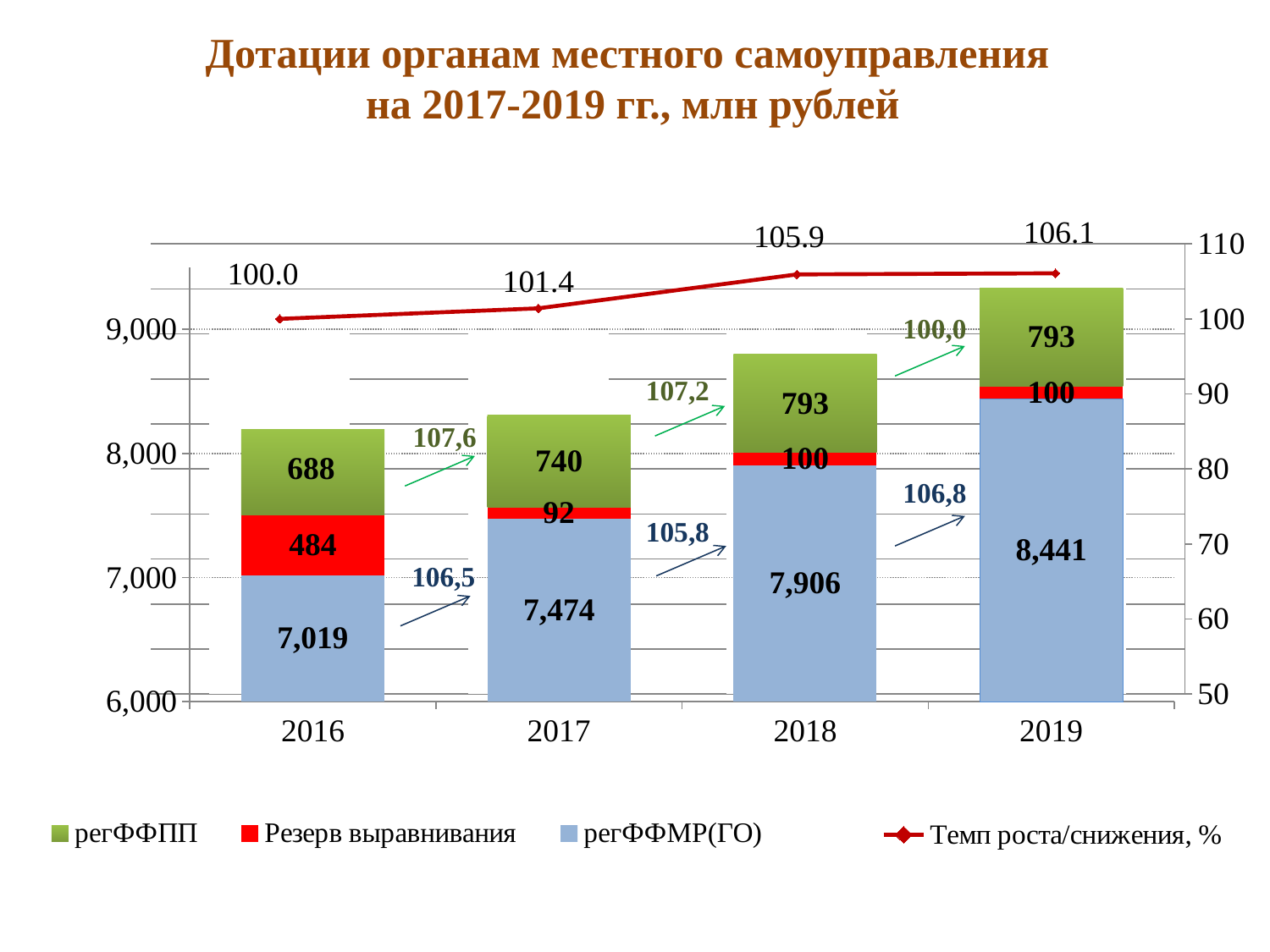
In which year is регФФМР(ГО) highest? 2019 What is the total of the stacked bar for 2016? 8,191 How many years are shown on the x axis? 4 Does the Темп роста/снижения, % line rise or fall from 2016 to 2019? rise In which year is Резерв выравнивания lowest? 2017 What is the value of регФФПП for 2018? 793 How many series does the legend list? 4 What is the value of регФФМР(ГО) for 2017? 7,474 Which is larger, регФФПП in 2016 or регФФПП in 2017? 2017 What is the value of Темп роста/снижения, % for 2019? 106.1 What is the difference between регФФМР(ГО) in 2019 and in 2018? 535 What is the value of Резерв выравнивания for 2016? 484